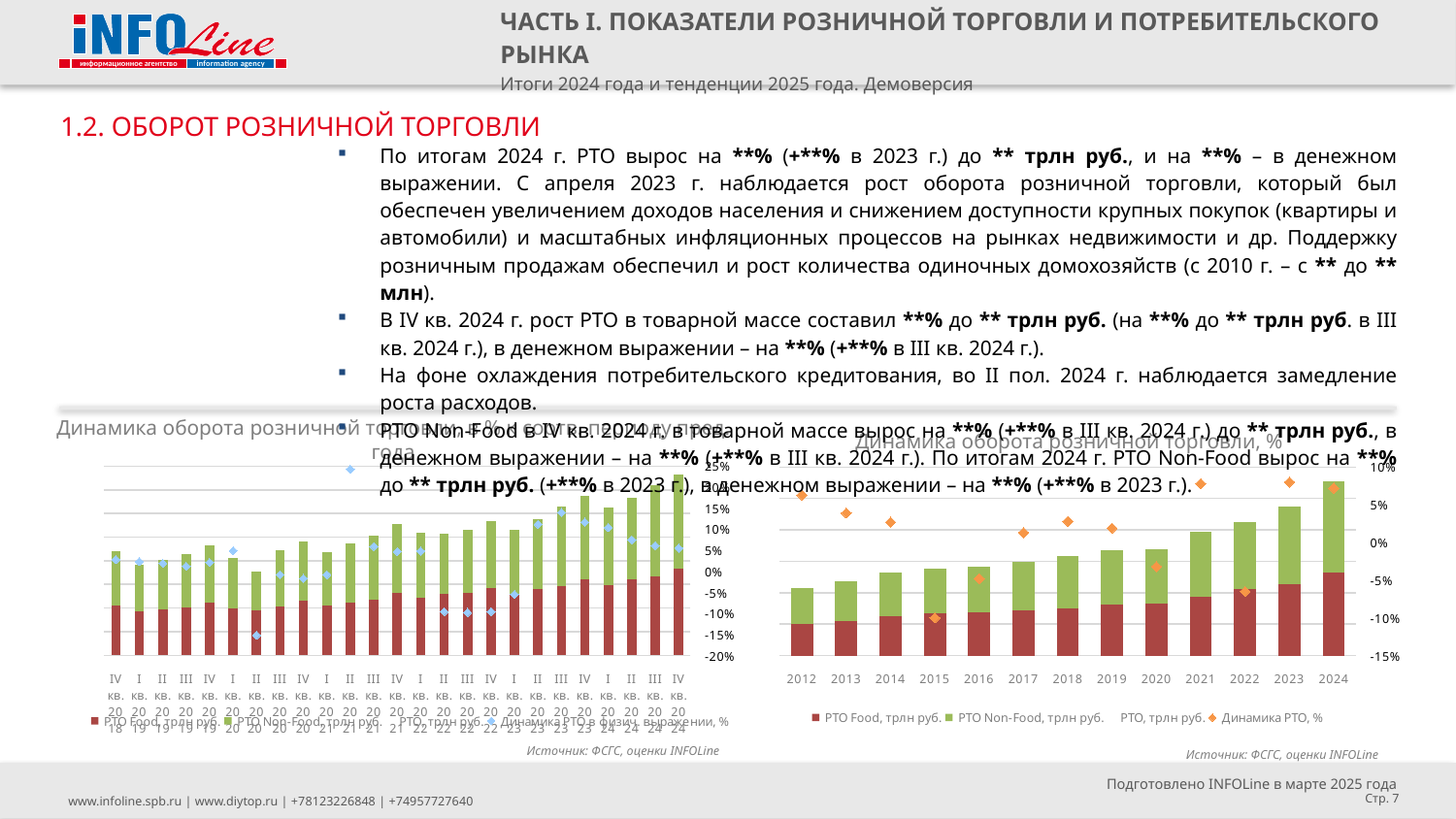
In the right-hand chart, do the stacked bars generally rise or fall from 2012 to 2024? rise In the right-hand chart, is the 'Динамика РТО, %' value for 2022 greater or less than 0%? less What kind of chart is the right-hand chart titled 'Динамика оборота розничной торговли, %'? combination bar and line chart (stacked bars with diamond markers) In the right-hand chart, is the 'Динамика РТО, %' value for 2021 greater or less than 0%? greater How many series does the legend of the right-hand chart list? 4 In the right-hand chart, is the 'Динамика РТО, %' value for 2015 greater or less than -5%? less In the left-hand quarterly chart, which quarter has the tallest stacked bar? IV кв. 2024 In the right-hand chart, which year has the shortest stacked bar? 2012 In the right-hand chart (2012–2024), how many years are shown on the x axis? 13 In the right-hand chart, which year has the lowest value of 'Динамика РТО, %'? 2015 In the right-hand chart, which year has the tallest stacked bar? 2024 In the left-hand quarterly chart, how many quarters are shown on the x axis? 25